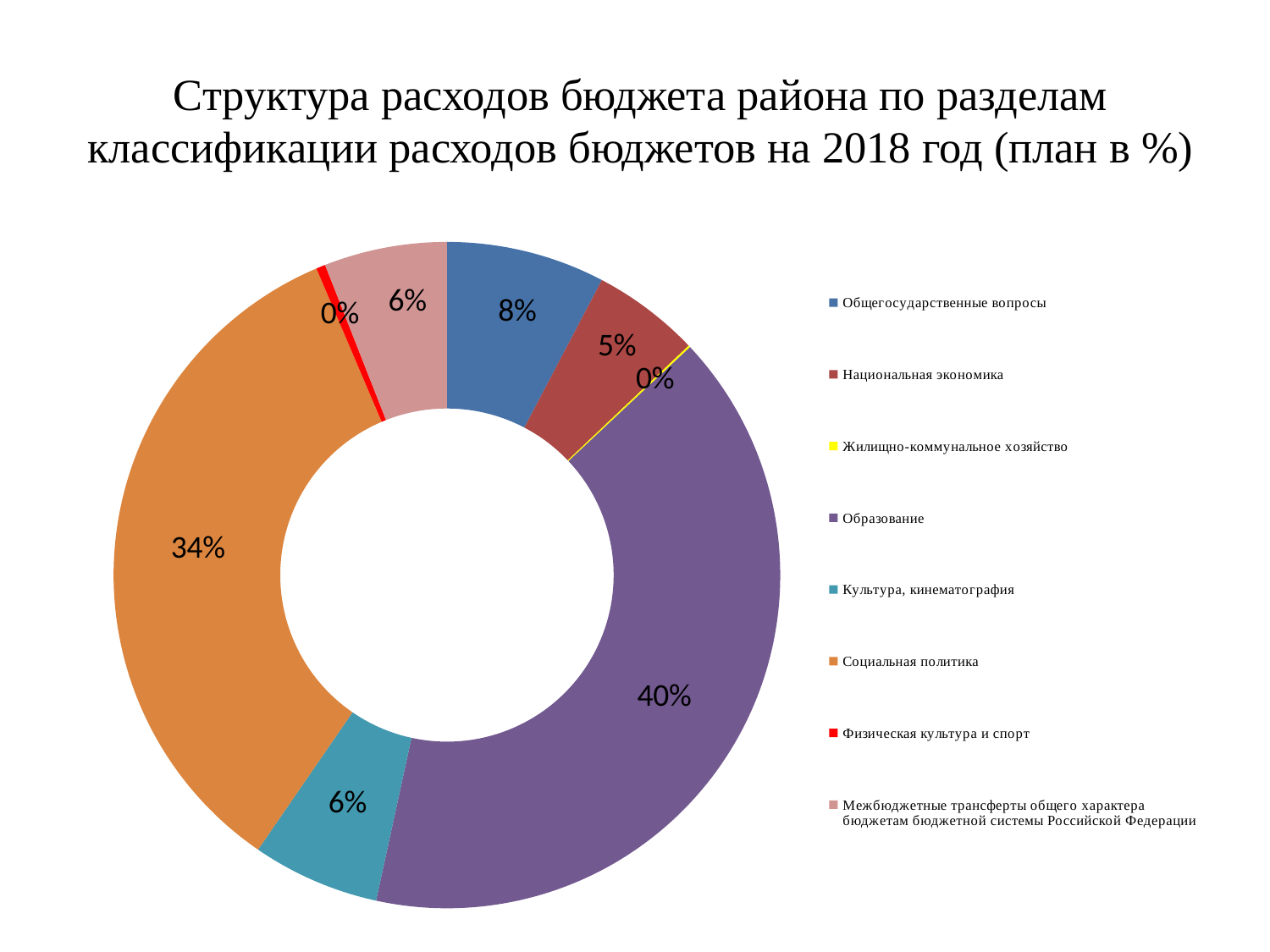
What colour is the slice for Физическая культура и спорт? red What is the value shown for Общегосударственные вопросы? 8% What is the value shown for Культура, кинематография? 6% Which is larger, the share for Общегосударственные вопросы or the share for Национальная экономика? Общегосударственные вопросы What is the value shown for Жилищно-коммунальное хозяйство? 0% Which category has the largest share of the chart? Образование What share of the chart does Образование account for? 40% What kind of chart is shown on the slide? doughnut chart What share of the chart does Социальная политика account for? 34% What is the difference between the shares of Образование and Социальная политика? 6% What is the value shown for Национальная экономика? 5% How many categories does the legend list? 8